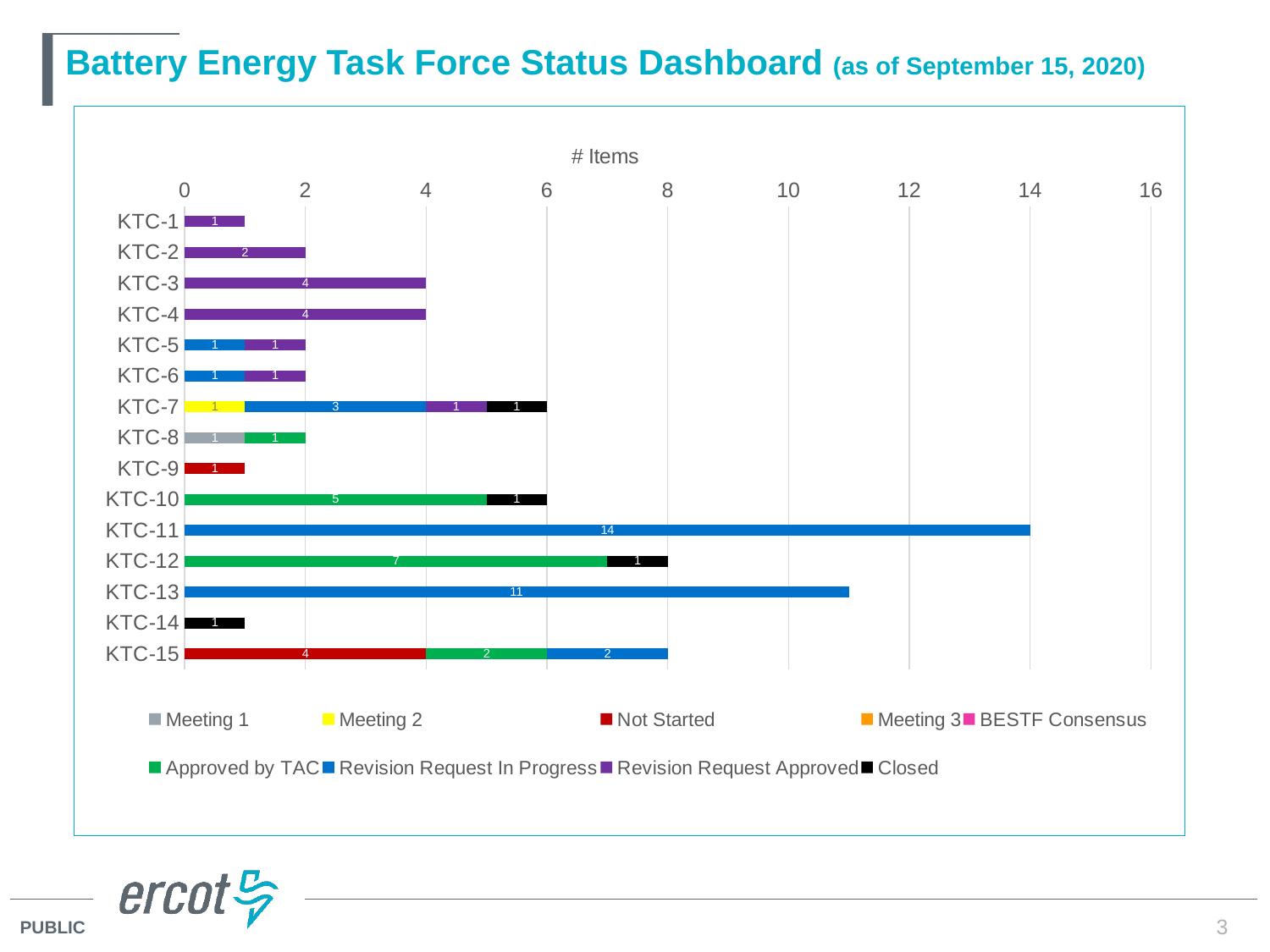
How many KTC categories are plotted on the chart? 15 How many series does the legend list? 9 What is the Not Started value for KTC-15? 4 What type of chart is shown on the slide? Stacked bar chart What is the total number of items for KTC-7? 6 What is the difference between the Revision Request In Progress values for KTC-11 and KTC-13? 3 What is the title of the horizontal axis? # Items What is the Revision Request In Progress value for KTC-11? 14 What is the Approved by TAC value for KTC-12? 7 Which KTC has the longest bar (the most items)? KTC-11 What is the total number of items for KTC-15? 8 Which has a larger Approved by TAC value, KTC-10 or KTC-12? KTC-12